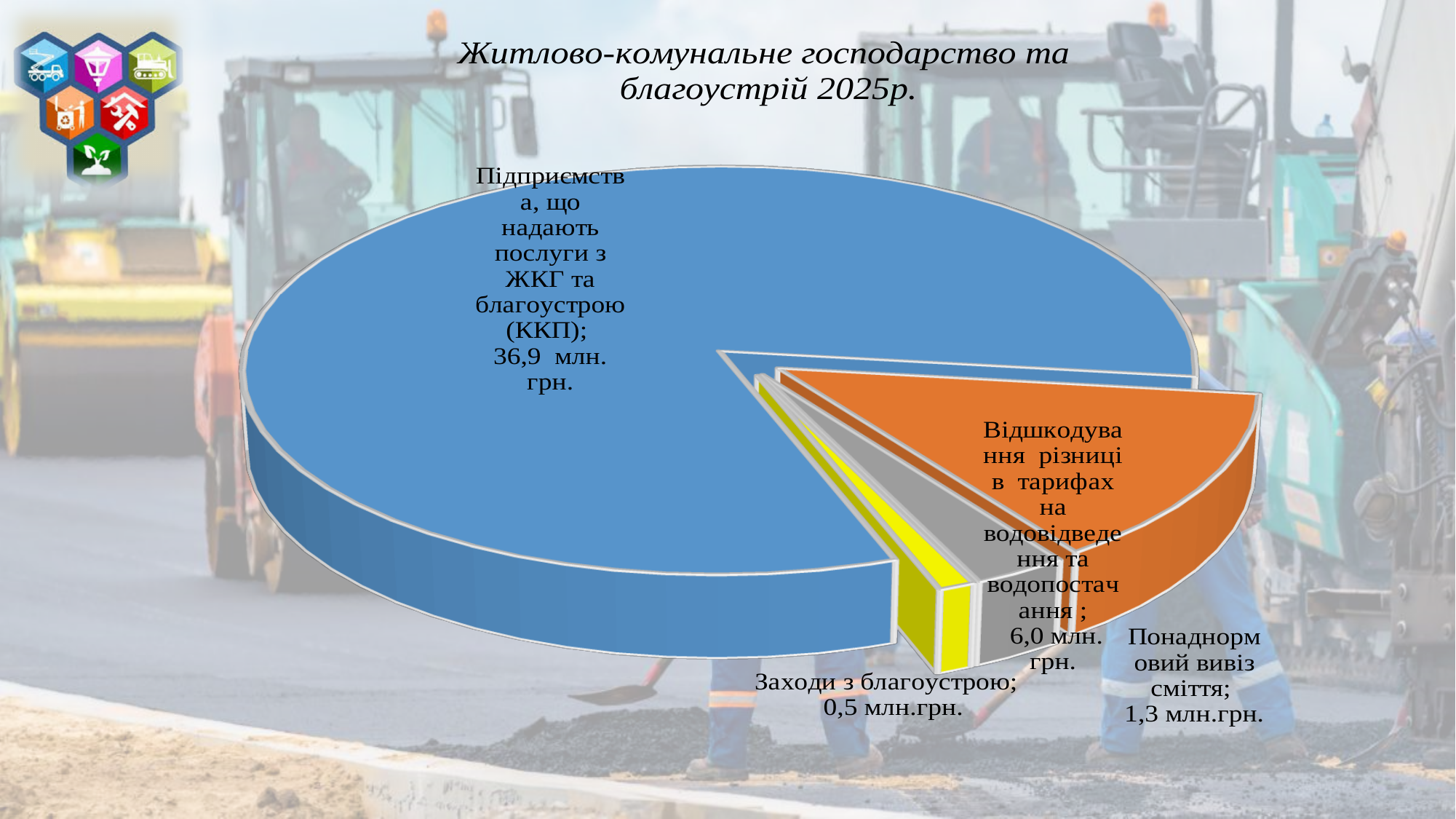
What is the value for "Відшкодування різниці в тарифах на водовідведення та водопостачання"? 6,0 млн. грн. Which category has the largest slice of the pie? Підприємства, що надають послуги з ЖКГ та благоустрою (ККП) What is the difference between the values for "Відшкодування різниці в тарифах на водовідведення та водопостачання" and "Понаднормовий вивіз сміття"? 4,7 млн.грн. How many slices does the pie chart have? 4 Which category has the smallest slice of the pie? Заходи з благоустрою What is the value for "Понаднормовий вивіз сміття"? 1,3 млн.грн. Which is larger: "Понаднормовий вивіз сміття" or "Заходи з благоустрою"? Понаднормовий вивіз сміття What is the value for "Підприємства, що надають послуги з ЖКГ та благоустрою (ККП)"? 36,9 млн. грн. What is the value for "Заходи з благоустрою"? 0,5 млн.грн. What colour is the slice for "Відшкодування різниці в тарифах на водовідведення та водопостачання"? Orange What kind of chart is shown on the slide? Pie chart What is the title of the chart on the slide? Житлово-комунальне господарство та благоустрій 2025р.